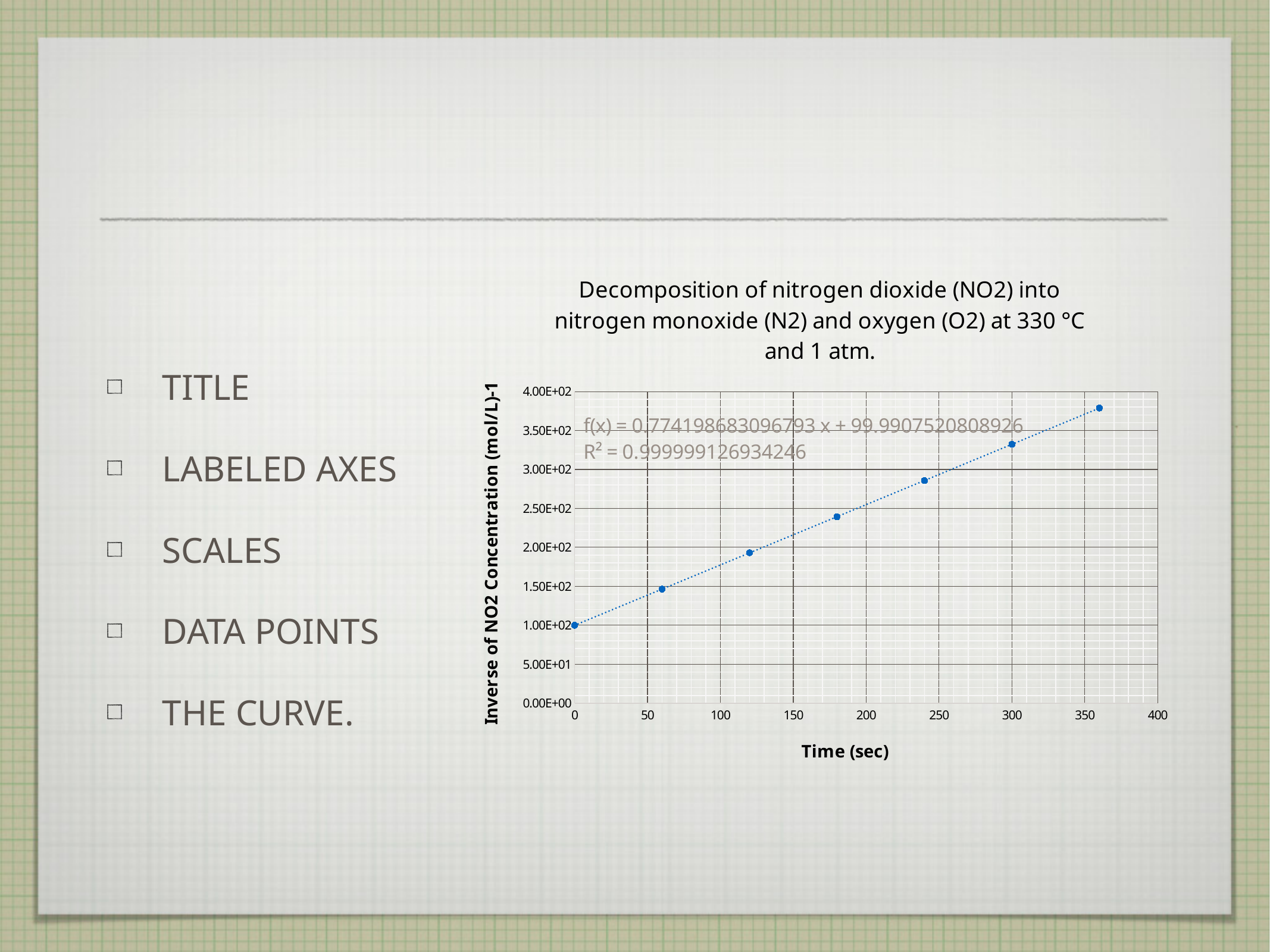
Is the value at 240 sec greater or less than 3.00E+02? less What R² value is printed on the chart? 0.999999126934246 Is the value at 300 sec greater or less than 3.00E+02? greater At which time (sec) is the inverse of NO2 concentration lowest? 0 Which has the larger inverse of NO2 concentration: the point at 300 sec or the point at 120 sec? 300 sec How many data points are plotted on the chart? 7 Is the value at 360 sec greater or less than 3.50E+02? greater What kind of chart is shown on the slide? Scatter chart Do the plotted values rise or fall as time increases along the x axis? Rise At which time (sec) is the inverse of NO2 concentration highest? 360 What is the label of the x axis? Time (sec)